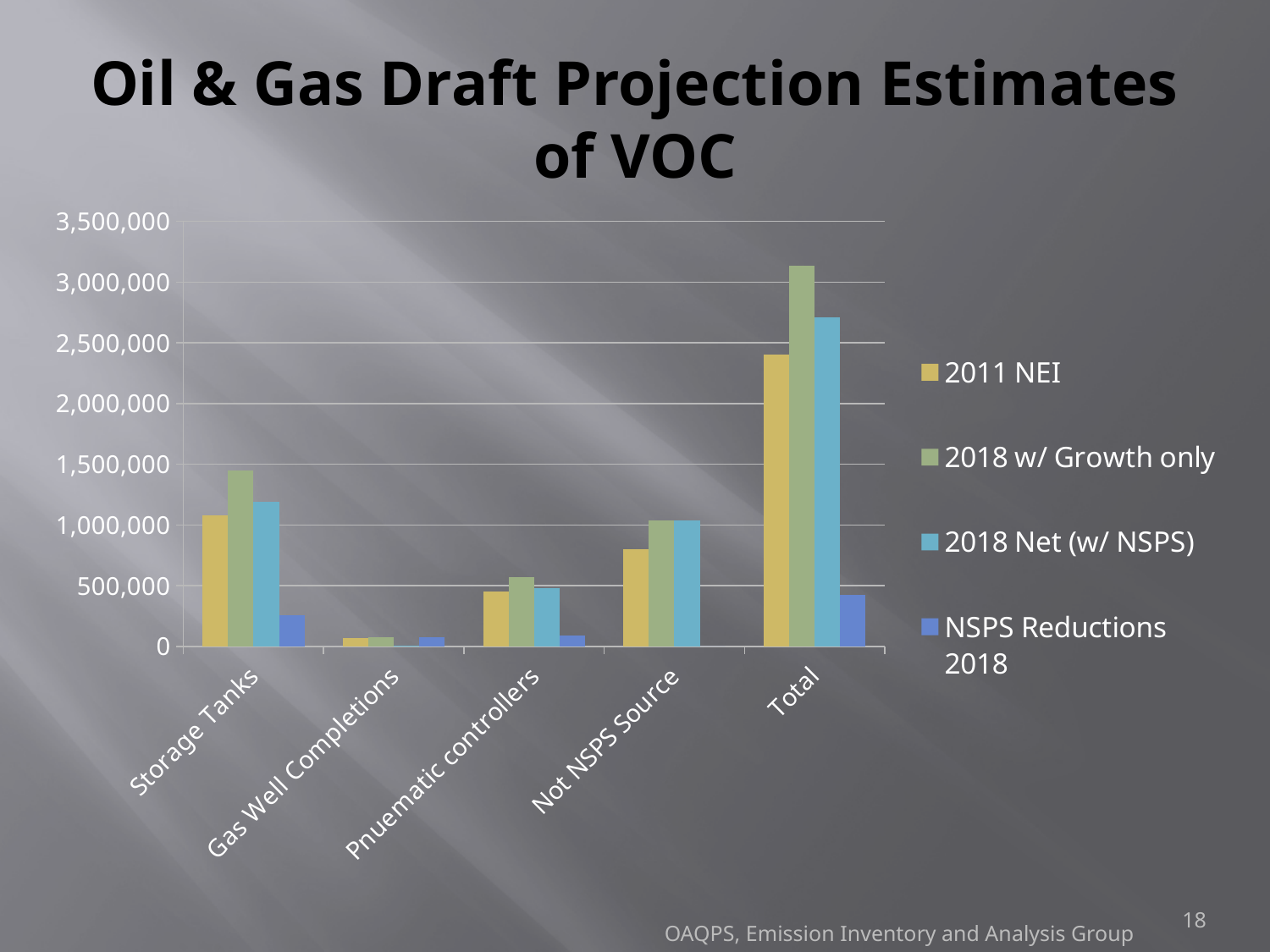
Is the NSPS Reductions 2018 value for Total greater or less than 500,000? less For Total, which is larger: the 2011 NEI value or the 2018 Net (w/ NSPS) value? 2018 Net (w/ NSPS) Is the 2011 NEI value for Storage Tanks greater or less than 1,000,000? greater For Storage Tanks, which is larger: the 2011 NEI value or the 2018 w/ Growth only value? 2018 w/ Growth only What kind of chart is shown on the slide? bar chart How many categories are shown on the x axis? 5 Is the 2018 w/ Growth only value for Total greater or less than 3,000,000? greater What is the title of the slide containing the chart? Oil & Gas Draft Projection Estimates of VOC How many series does the legend list? 4 Which category has the highest value for the 2018 w/ Growth only series? Total Which category has the lowest value for the 2011 NEI series? Gas Well Completions